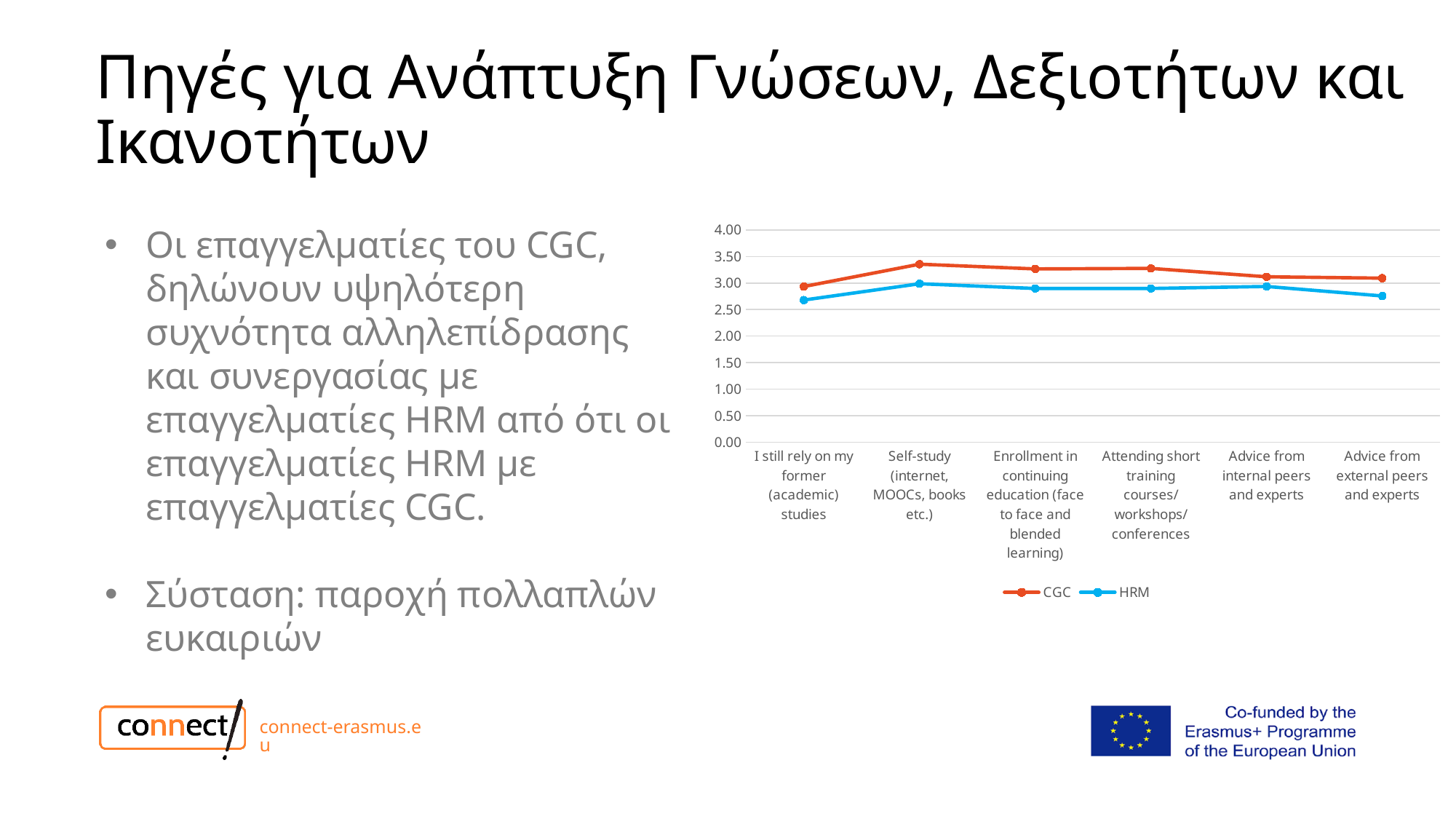
What kind of chart is shown on the slide? line chart Which series has the higher value for 'Self-study (internet, MOOCs, books etc.)', CGC or HRM? CGC For which category is the CGC series lowest? I still rely on my former (academic) studies Is the HRM value for 'I still rely on my former (academic) studies' greater or less than 3.00? less How many categories are shown along the x axis of the chart? 6 For which category is the CGC series highest? Self-study (internet, MOOCs, books etc.) Is the CGC value for 'Self-study (internet, MOOCs, books etc.)' greater or less than 3.00? greater How many series does the chart's legend list? 2 Does the HRM series rise or fall from 'I still rely on my former (academic) studies' to 'Self-study (internet, MOOCs, books etc.)'? rise Is the CGC value for 'Self-study (internet, MOOCs, books etc.)' greater or less than 3.50? less Which series has the higher value for 'Advice from external peers and experts', CGC or HRM? CGC Which colour is used for the HRM series in the chart? blue